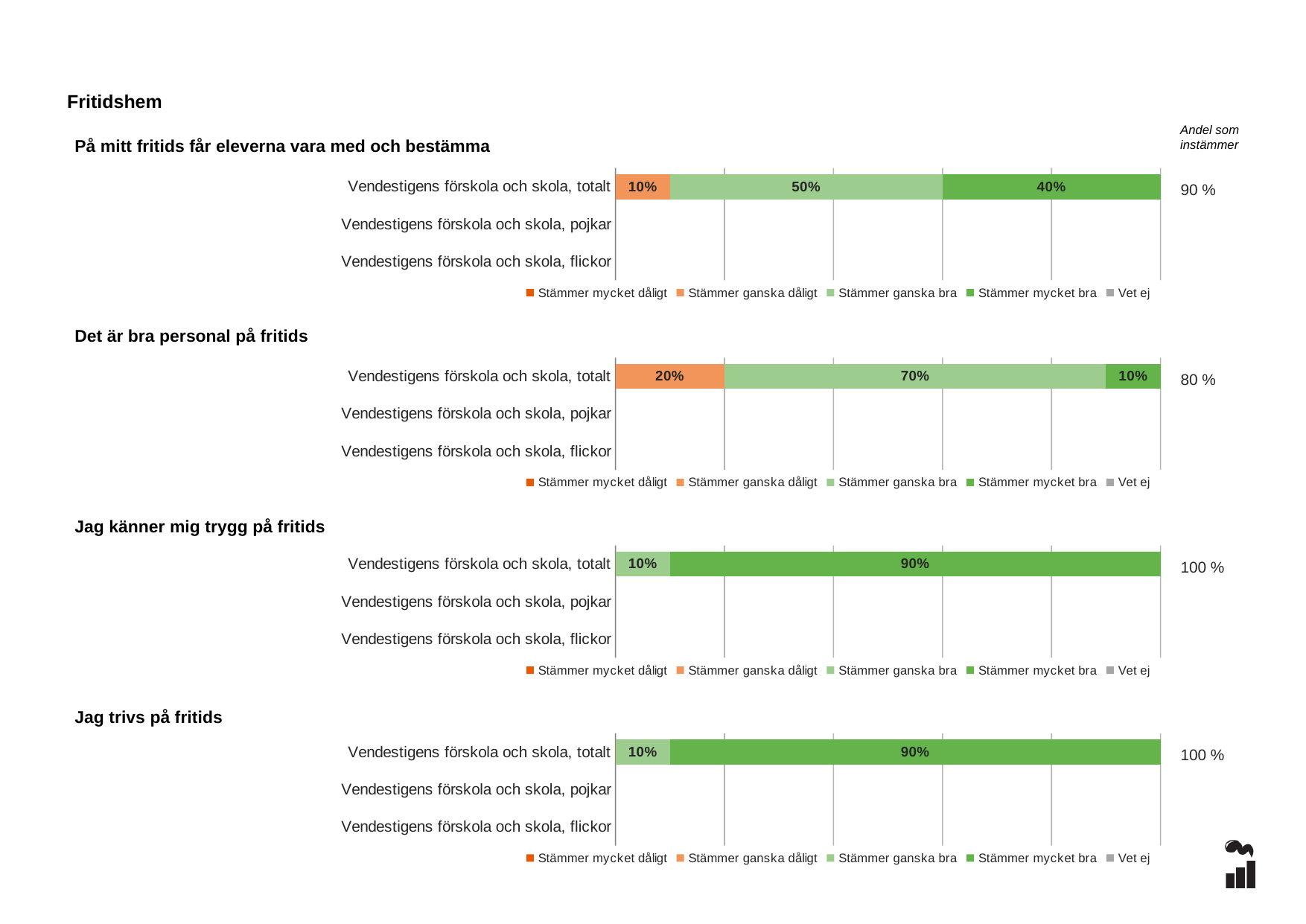
What is the 'Andel som instämmer' value shown for the chart 'På mitt fritids får eleverna vara med och bestämma'? 90 % In the chart 'Det är bra personal på fritids', which response category has the largest share for Vendestigens förskola och skola, totalt? Stämmer ganska bra In the chart 'På mitt fritids får eleverna vara med och bestämma', what is the value for 'Stämmer ganska bra' for Vendestigens förskola och skola, totalt? 50% In the chart 'Det är bra personal på fritids', what is the value for 'Stämmer ganska dåligt' for Vendestigens förskola och skola, totalt? 20% What is the 'Andel som instämmer' value shown for the chart 'Det är bra personal på fritids'? 80 % In the chart 'Det är bra personal på fritids', which is larger for Vendestigens förskola och skola, totalt: 'Stämmer ganska dåligt' or 'Stämmer mycket bra'? Stämmer ganska dåligt In the chart 'Jag trivs på fritids', what is the difference between the 'Stämmer mycket bra' and 'Stämmer ganska bra' values for Vendestigens förskola och skola, totalt? 80% In the chart 'Jag känner mig trygg på fritids', what is the value for 'Stämmer mycket bra' for Vendestigens förskola och skola, totalt? 90% How many series does the legend list in the chart 'Jag trivs på fritids'? 5 How many category rows are listed on the y axis of the chart 'På mitt fritids får eleverna vara med och bestämma'? 3 What kind of chart is 'Jag känner mig trygg på fritids'? Stacked bar chart In the chart 'På mitt fritids får eleverna vara med och bestämma', what is the value for 'Stämmer mycket bra' for Vendestigens förskola och skola, totalt? 40%